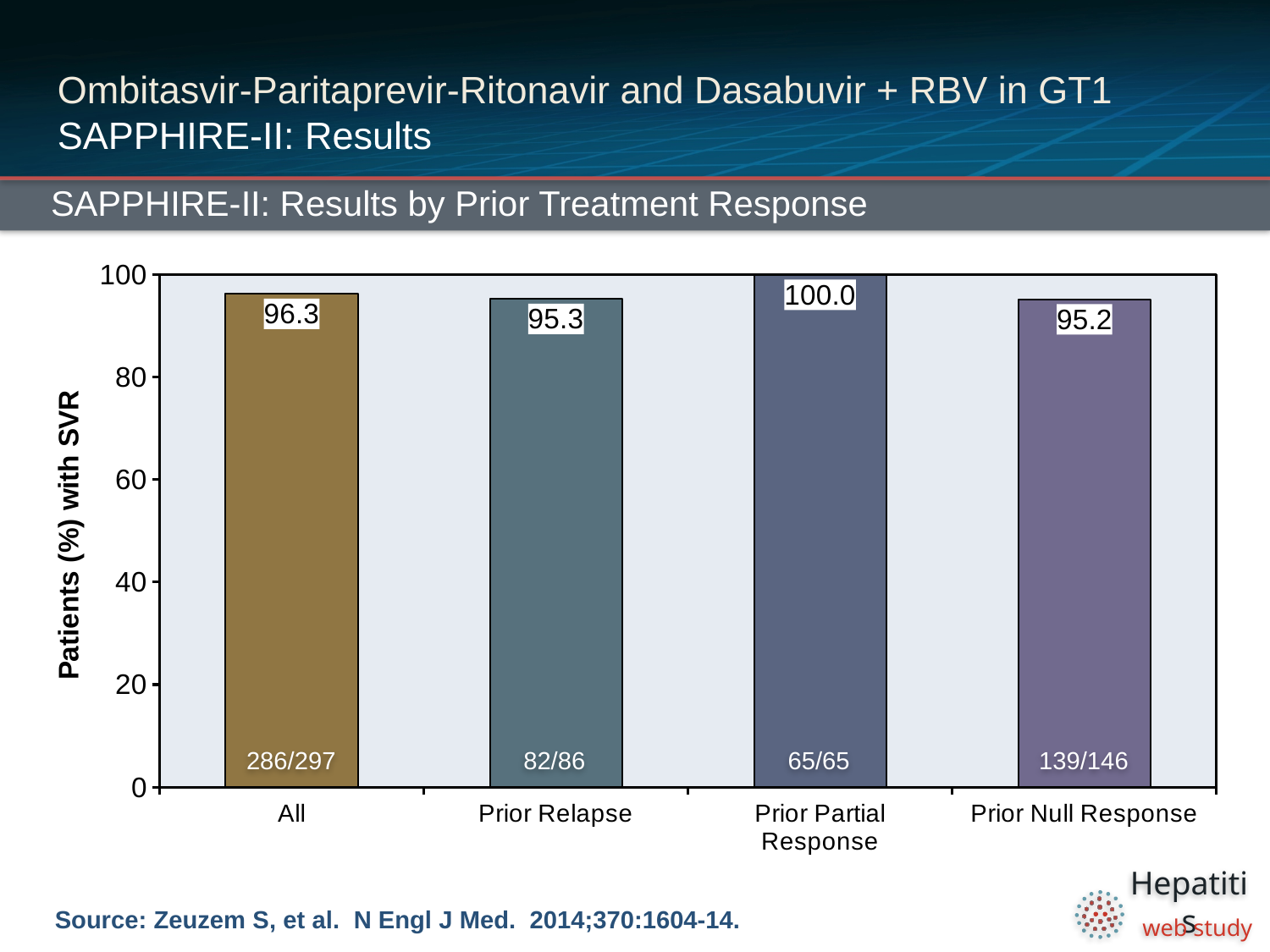
What is the SVR rate for the Prior Relapse group? 95.3 Which group has the highest SVR rate? Prior Partial Response What is the label of the y axis? Patients (%) with SVR How many patients achieved SVR out of the total in the Prior Null Response group, as labeled on the bar? 139/146 Which group has the lowest SVR rate? Prior Null Response What is the difference in SVR rate between the Prior Partial Response group and the All group? 3.7 What is the SVR rate for the Prior Null Response group? 95.2 Is the SVR rate for the Prior Relapse group greater or less than 80? greater What type of chart is shown? bar chart What is the SVR rate for the All group? 96.3 How many groups are shown on the x axis? 4 Which has a higher SVR rate, the All group or the Prior Relapse group? All